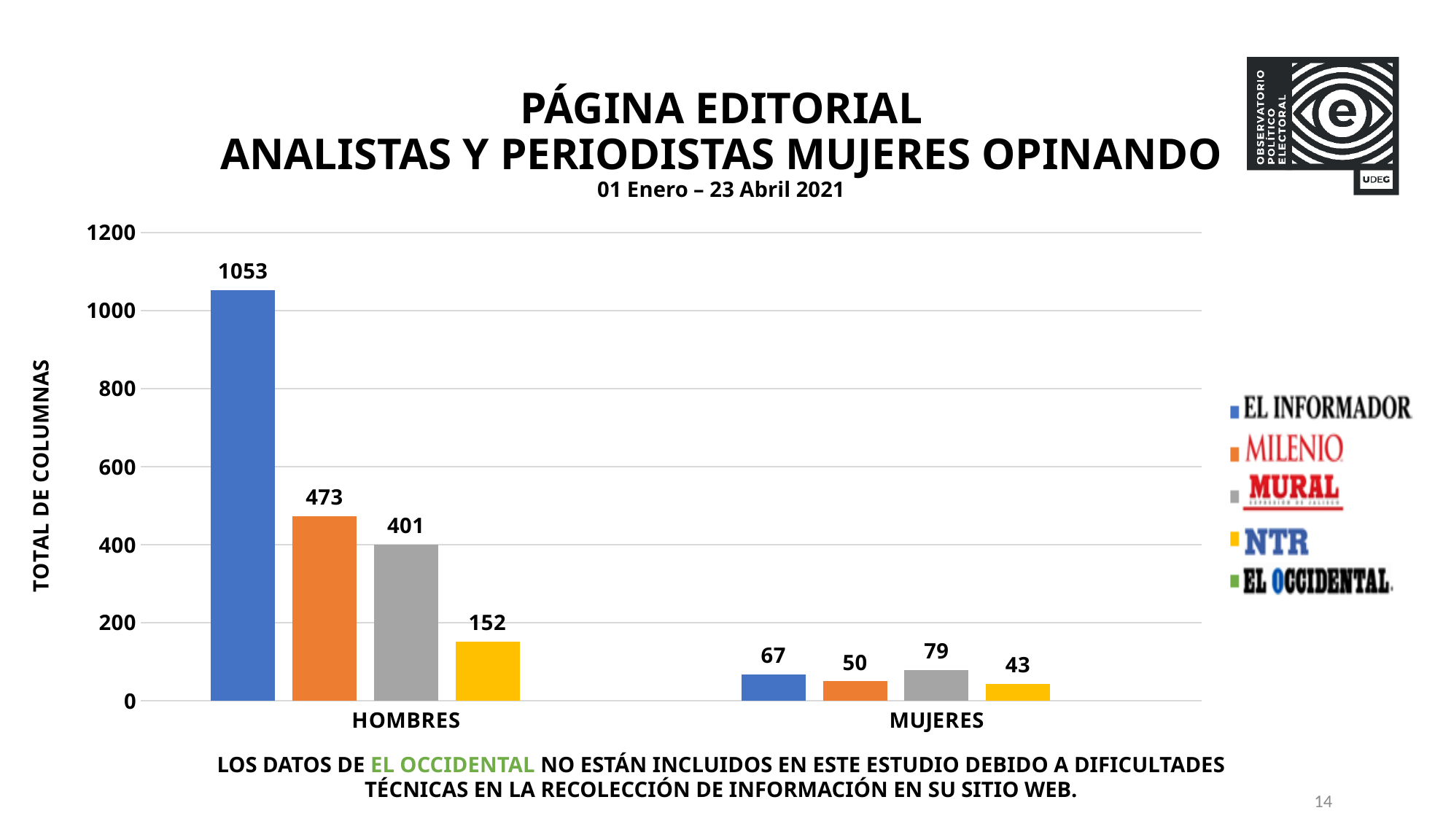
Which is larger: the MILENIO value for HOMBRES or the MURAL value for HOMBRES? MILENIO What is the value for MURAL in the MUJERES category? 79 What is the total of the four plotted values in the MUJERES category? 239 How many categories are shown on the x axis? 2 Which series has the lowest value in the HOMBRES category? NTR What is the value for NTR in the HOMBRES category? 152 What is the difference between the MILENIO values for HOMBRES and MUJERES? 423 What kind of chart is shown on the slide? Bar chart What is the label of the y axis? TOTAL DE COLUMNAS Which series has the highest value in the MUJERES category? MURAL What is the value for EL INFORMADOR in the HOMBRES category? 1053 How many series does the legend list? 5